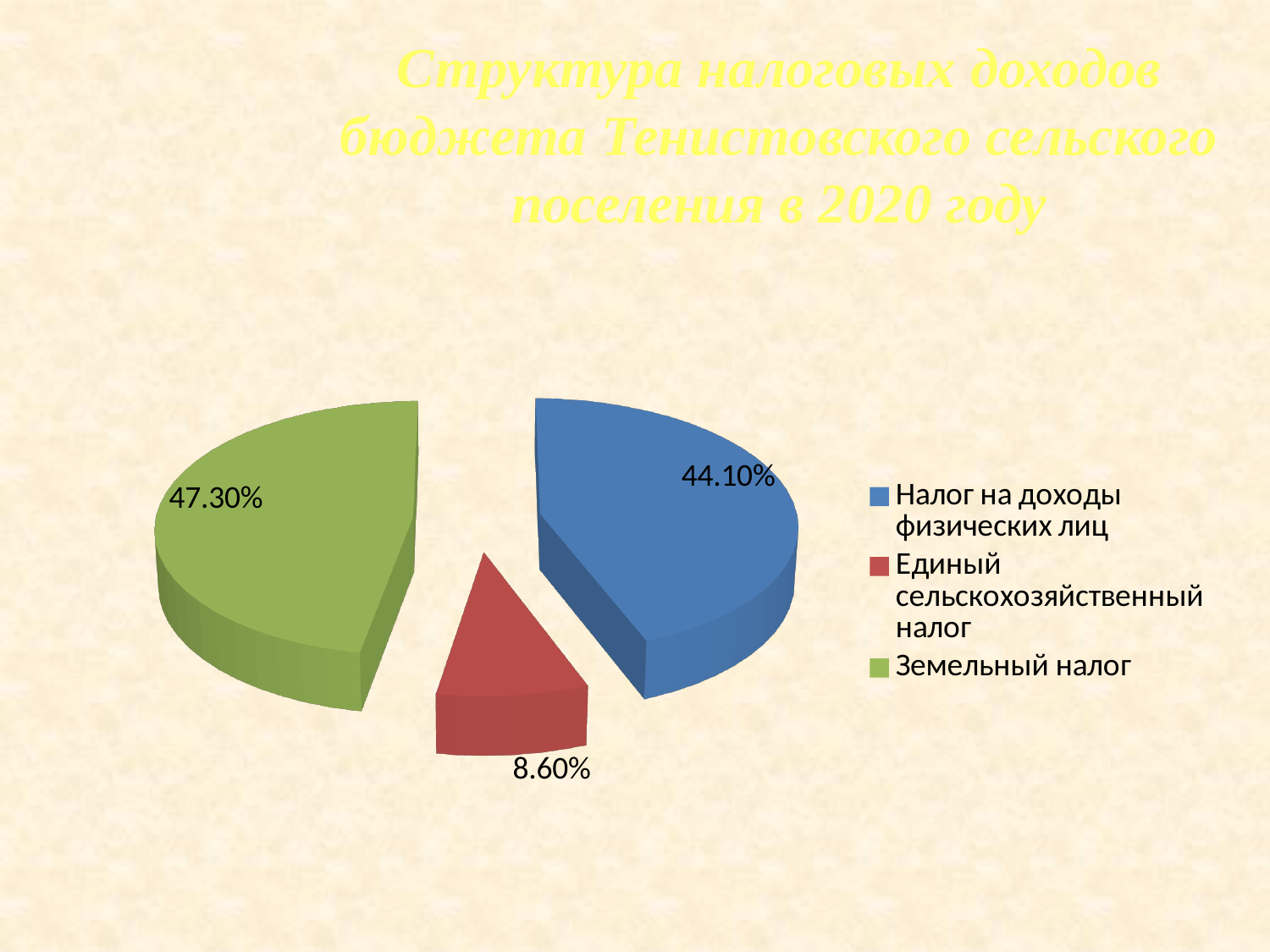
What is the difference in percentage points between Налог на доходы физических лиц and Единый сельскохозяйственный налог? 35.50% What share of the pie does Земельный налог have? 47.30% What is the difference in percentage points between Земельный налог and Налог на доходы физических лиц? 3.20% What share of the pie does Налог на доходы физических лиц have? 44.10% Which is larger: the share for Налог на доходы физических лиц or the share for Единый сельскохозяйственный налог? Налог на доходы физических лиц Which category has the smallest slice of the pie? Единый сельскохозяйственный налог What share of the pie does Единый сельскохозяйственный налог have? 8.60% How many categories are shown in the pie chart? 3 What colour is the slice for Земельный налог? Green What is the title of the chart on the slide? Структура налоговых доходов бюджета Тенистовского сельского поселения в 2020 году What kind of chart is shown on the slide? Pie chart Which category has the largest slice of the pie? Земельный налог